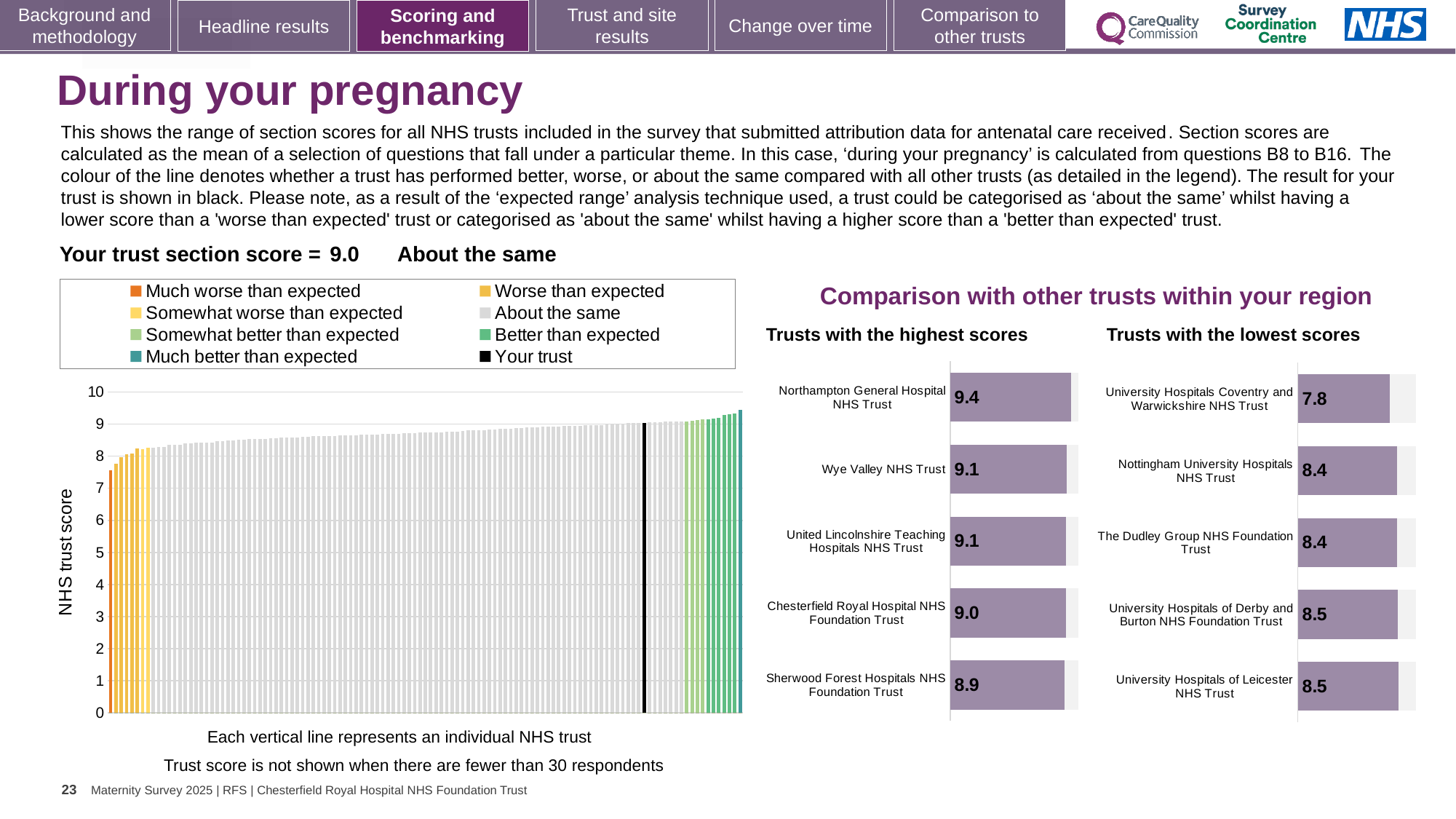
What kind of chart is the large chart on the left showing all NHS trusts? Bar chart In the 'Trusts with the highest scores' chart, what is the difference between the scores of Northampton General Hospital NHS Trust and Sherwood Forest Hospitals NHS Foundation Trust? 0.5 In the 'Trusts with the lowest scores' chart, which trust has the lowest score? University Hospitals Coventry and Warwickshire NHS Trust In the large chart on the left, is the value of the black bar (Your trust) greater or less than 8? greater In the 'Trusts with the highest scores' chart, what is the score for Northampton General Hospital NHS Trust? 9.4 In the large chart on the left, do the trust scores rise or fall from left to right? Rise In the 'Trusts with the highest scores' chart, what is the score for Sherwood Forest Hospitals NHS Foundation Trust? 8.9 How many trusts are listed in the 'Trusts with the lowest scores' chart? 5 In the 'Trusts with the highest scores' chart, which trust has the highest score? Northampton General Hospital NHS Trust In the 'Trusts with the lowest scores' chart, what is the score for University Hospitals Coventry and Warwickshire NHS Trust? 7.8 In the 'Trusts with the lowest scores' chart, what is the difference between the scores of University Hospitals of Leicester NHS Trust and University Hospitals Coventry and Warwickshire NHS Trust? 0.7 Which is larger: the score for Wye Valley NHS Trust in the 'Trusts with the highest scores' chart or the score for Nottingham University Hospitals NHS Trust in the 'Trusts with the lowest scores' chart? Wye Valley NHS Trust